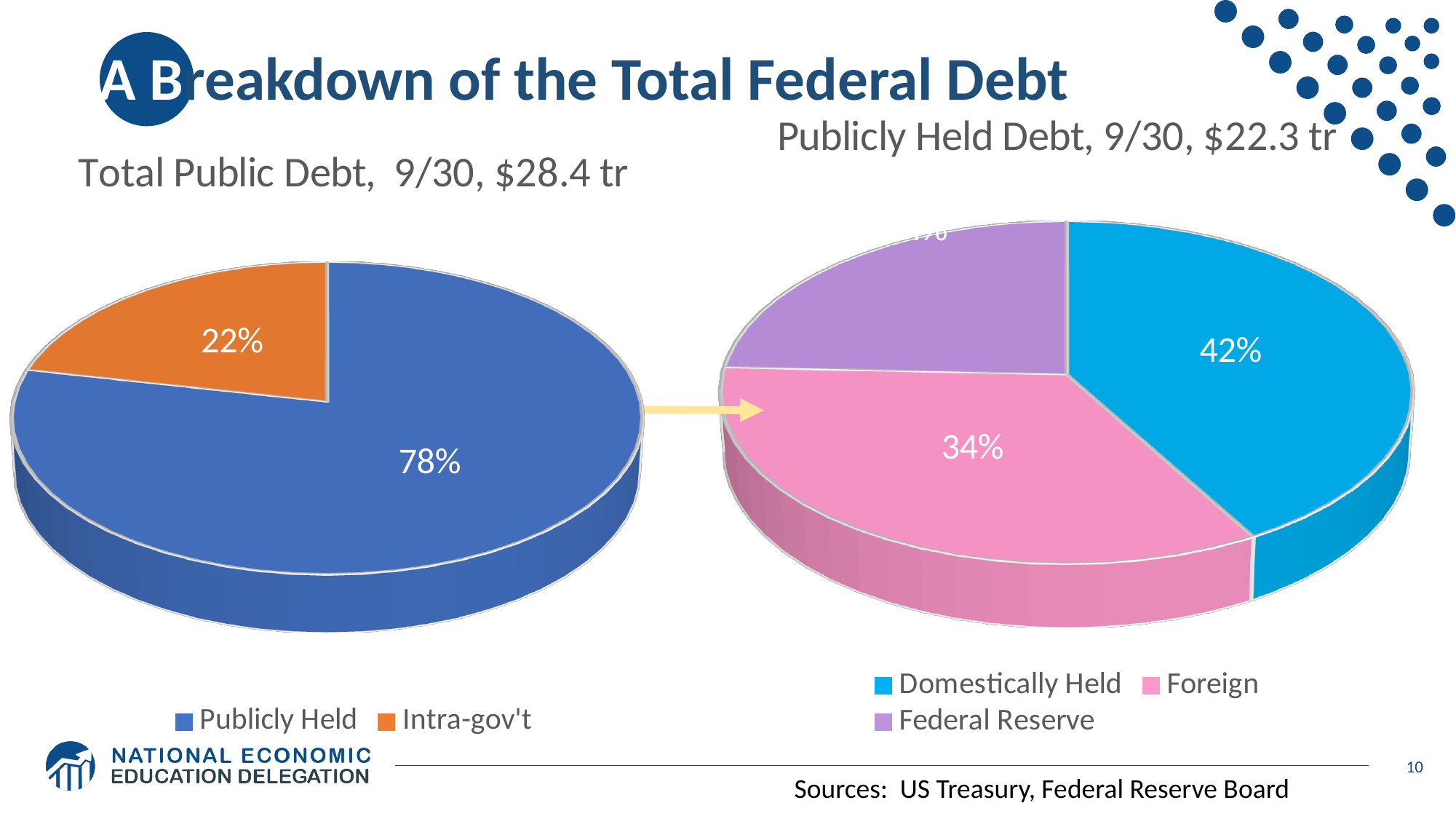
What kind of chart is used for the Total Public Debt breakdown? Pie chart In the Publicly Held Debt pie chart, what share is Domestically Held? 42% In the Publicly Held Debt pie chart, which category has the smallest share? Federal Reserve In the Publicly Held Debt pie chart, which is larger, Domestically Held or Federal Reserve? Domestically Held In the Total Public Debt pie chart, what is the difference in percentage points between Publicly Held and Intra-gov't? 56 In the Publicly Held Debt pie chart, what is the difference in percentage points between Domestically Held and Foreign? 8 In the Publicly Held Debt pie chart, what share is Foreign? 34% In the Publicly Held Debt pie chart, which category has the largest share? Domestically Held In the Total Public Debt pie chart, what share is Publicly Held? 78% In the Total Public Debt pie chart, what share is Intra-gov't? 22% In the Total Public Debt pie chart, which category has the largest share? Publicly Held How many categories does the legend of the Publicly Held Debt pie chart list? 3